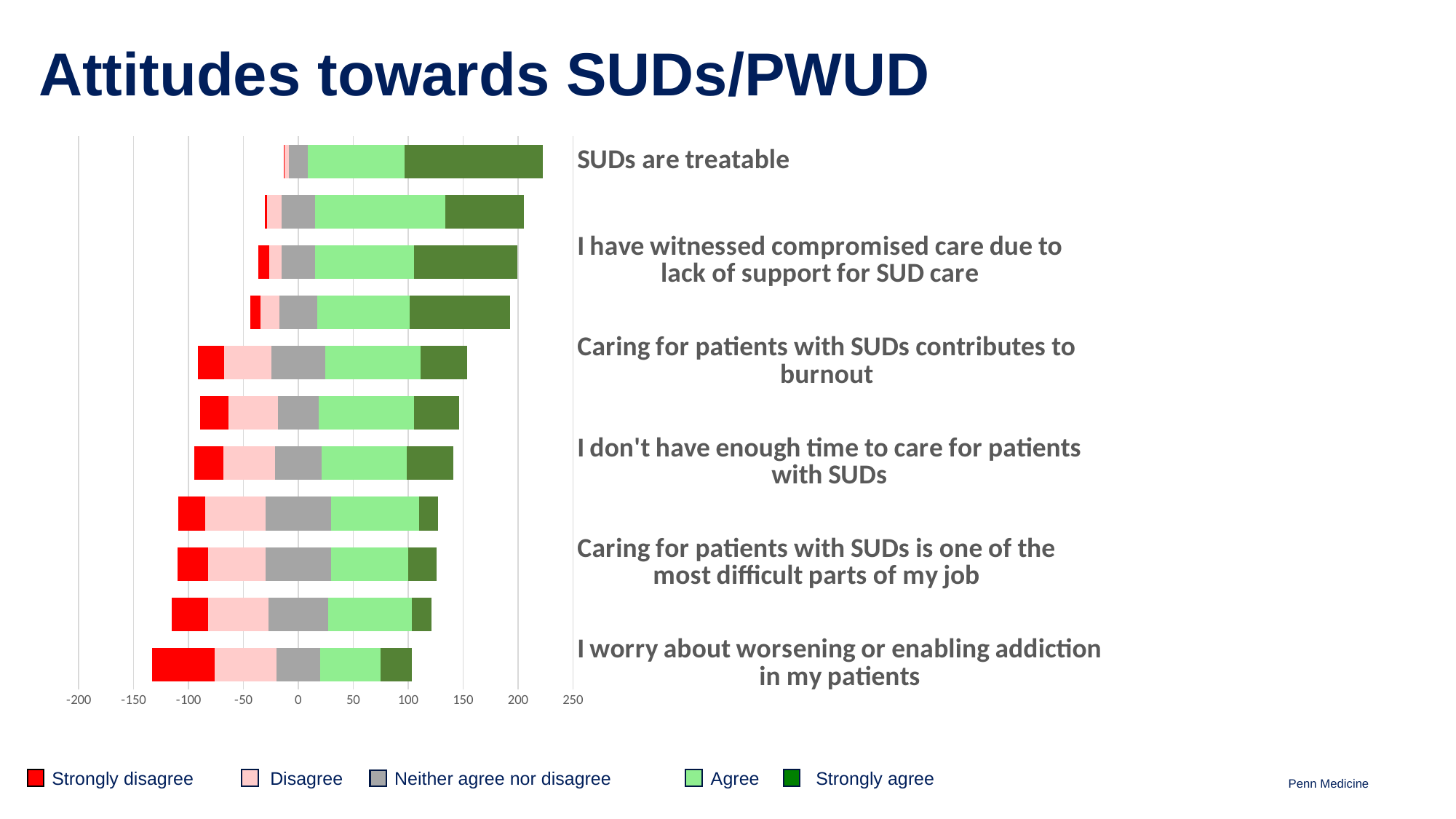
Is the right end of the bottom bar greater or less than 150? less Which bar extends furthest to the right on the positive (agree) side of the axis? The top bar (SUDs are treatable) What are the minimum and maximum values shown on the horizontal axis? -200 and 250 What are the five legend entries of the chart? Strongly disagree, Disagree, Neither agree nor disagree, Agree, Strongly agree Is the right end of the top bar (SUDs are treatable) greater or less than 200? greater Is the left end of the bottom bar (I worry about worsening or enabling addiction in my patients) greater or less than -100? less What is the title of the slide containing the chart? Attitudes towards SUDs/PWUD Moving from the top bar to the bottom bar, does the agreement (green) portion of the bars rise or fall? Fall How many bars are plotted in the chart? 11 Which bar extends furthest to the left on the negative (disagree) side of the axis? The bottom bar (I worry about worsening or enabling addiction in my patients) What kind of chart is shown on the slide? Stacked bar chart How many series does the legend list? 5